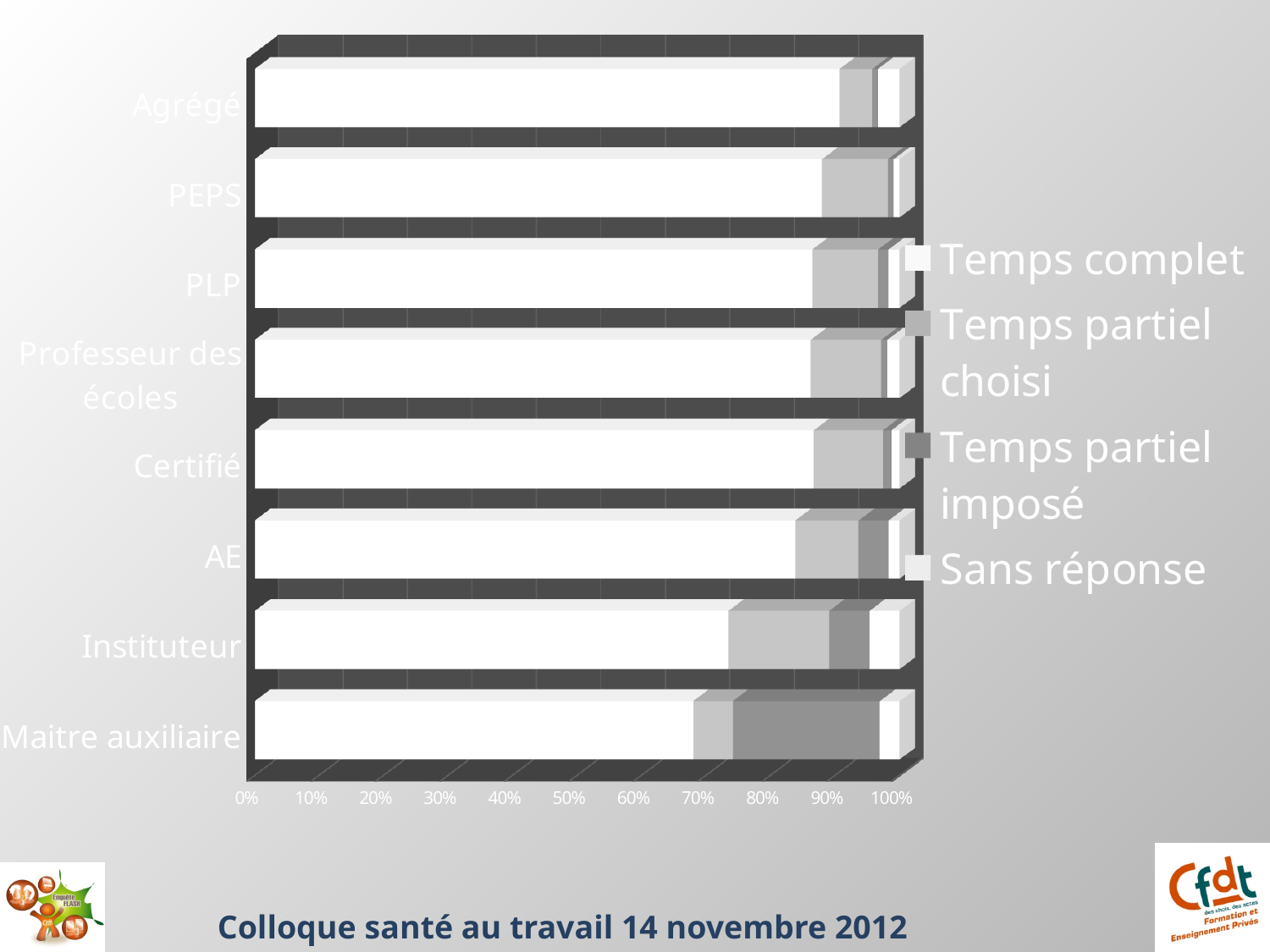
What kind of chart is shown on the slide? bar chart How many categories are shown on the vertical axis of the chart? 8 Is the Temps complet value for Agrégé greater or less than 80%? greater Which has a larger Temps complet share, Agrégé or Maitre auxiliaire? Agrégé How many series does the chart legend list? 4 What is the last entry listed in the chart legend? Sans réponse Which category has the smallest Temps complet share? Maitre auxiliaire Is the Temps complet value for Instituteur greater or less than 70%? greater Which category has the largest Temps complet share? Agrégé Is the Temps complet value for AE greater or less than 80%? greater Which has a larger Temps partiel imposé share, Maitre auxiliaire or Certifié? Maitre auxiliaire